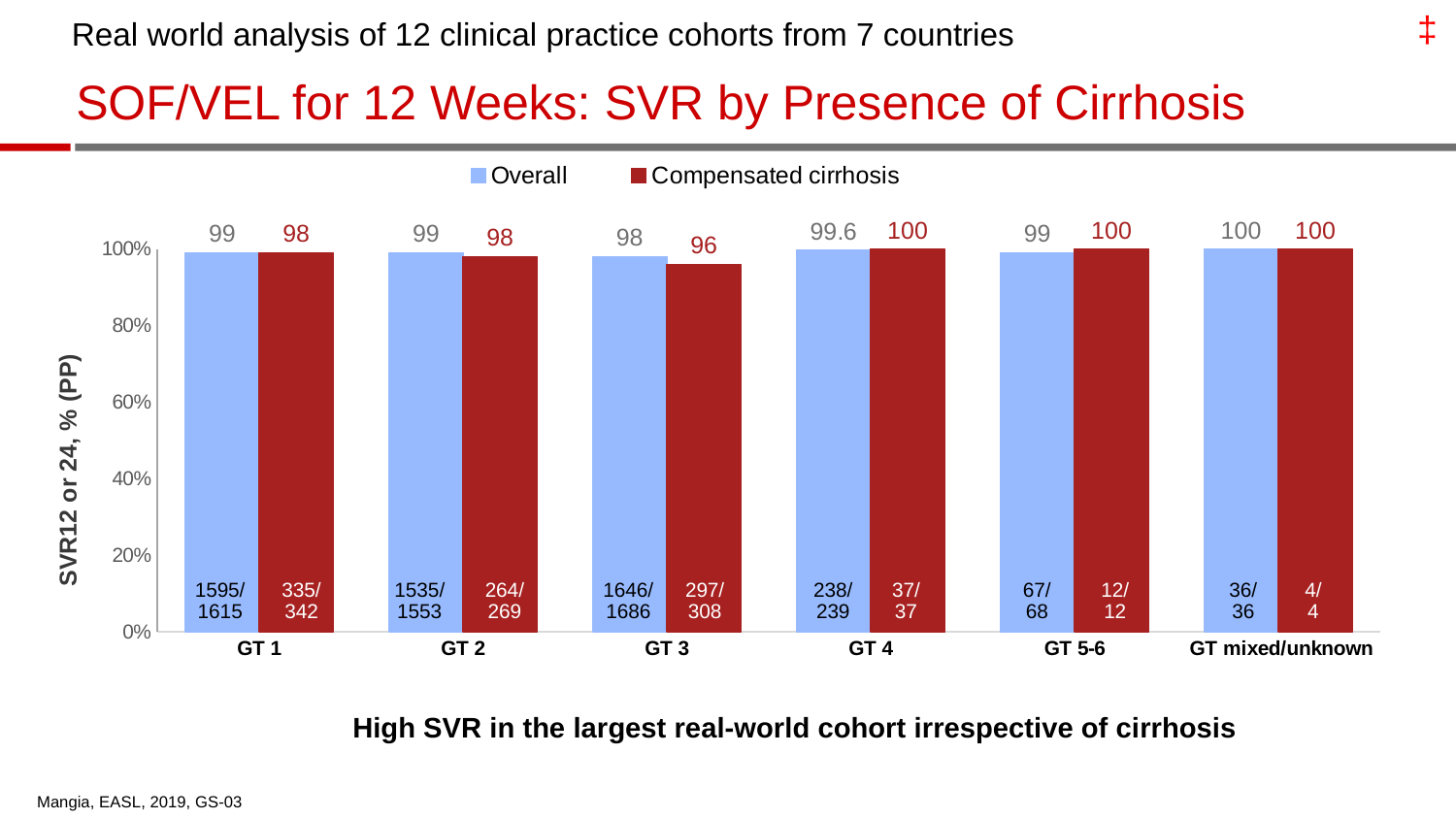
What is the patient fraction shown inside the Compensated cirrhosis bar for GT 5-6? 12/12 What is the patient fraction shown inside the Overall bar for GT 1? 1595/1615 Which genotype category has the lowest Compensated cirrhosis SVR value? GT 3 What is the label of the y axis? SVR12 or 24, % (PP) What kind of chart is shown on the slide? Bar chart How many series does the legend list? 2 For GT 1, which is larger: the Overall value or the Compensated cirrhosis value? Overall What is the Overall SVR value for GT 3? 98 What is the Compensated cirrhosis SVR value for GT 2? 98 What is the Overall SVR value for GT 4? 99.6 How many genotype categories are shown on the x axis? 6 What is the difference between the Overall and Compensated cirrhosis SVR values for GT 3? 2